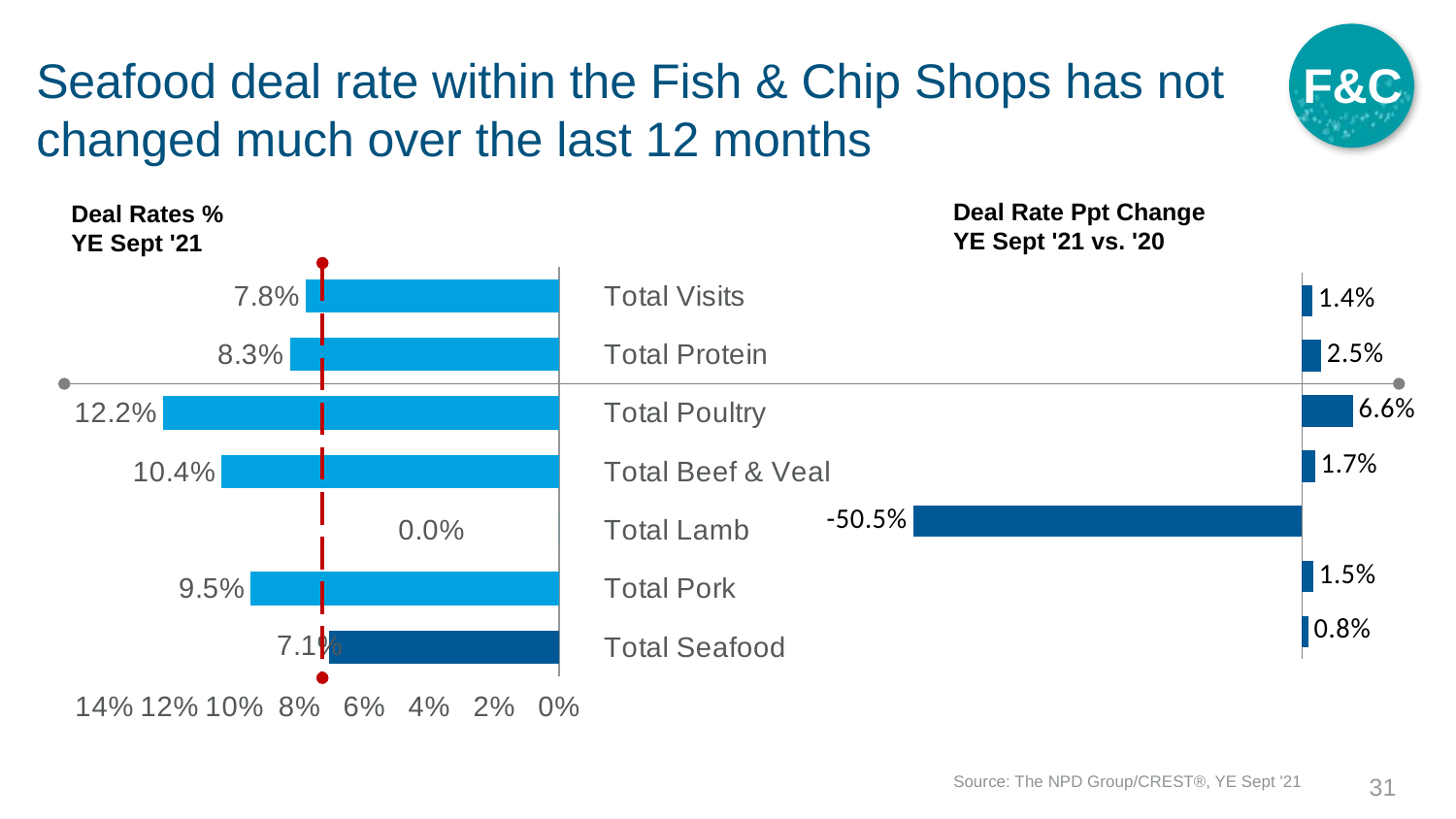
How many categories are shown in the 'Deal Rates % YE Sept '21' chart? 7 In the 'Deal Rates % YE Sept '21' chart, which category has the highest deal rate? Total Poultry In the 'Deal Rate Ppt Change YE Sept '21 vs. '20' chart, which category has the largest positive change? Total Poultry In the 'Deal Rates % YE Sept '21' chart, what is the deal rate for Total Seafood? 7.1% What type of chart is the 'Deal Rates % YE Sept '21' chart? Bar chart In the 'Deal Rate Ppt Change YE Sept '21 vs. '20' chart, what is the difference between the values for Total Protein and Total Visits? 1.1% In the 'Deal Rate Ppt Change YE Sept '21 vs. '20' chart, what is the value for Total Lamb? -50.5% In the 'Deal Rates % YE Sept '21' chart, what is the deal rate for Total Poultry? 12.2% In the 'Deal Rate Ppt Change YE Sept '21 vs. '20' chart, what is the value for Total Seafood? 0.8% In the 'Deal Rates % YE Sept '21' chart, what is the difference between the deal rates for Total Poultry and Total Seafood? 5.1% In the 'Deal Rates % YE Sept '21' chart, which has a higher deal rate, Total Pork or Total Protein? Total Pork In the 'Deal Rates % YE Sept '21' chart, which category has the lowest deal rate? Total Lamb